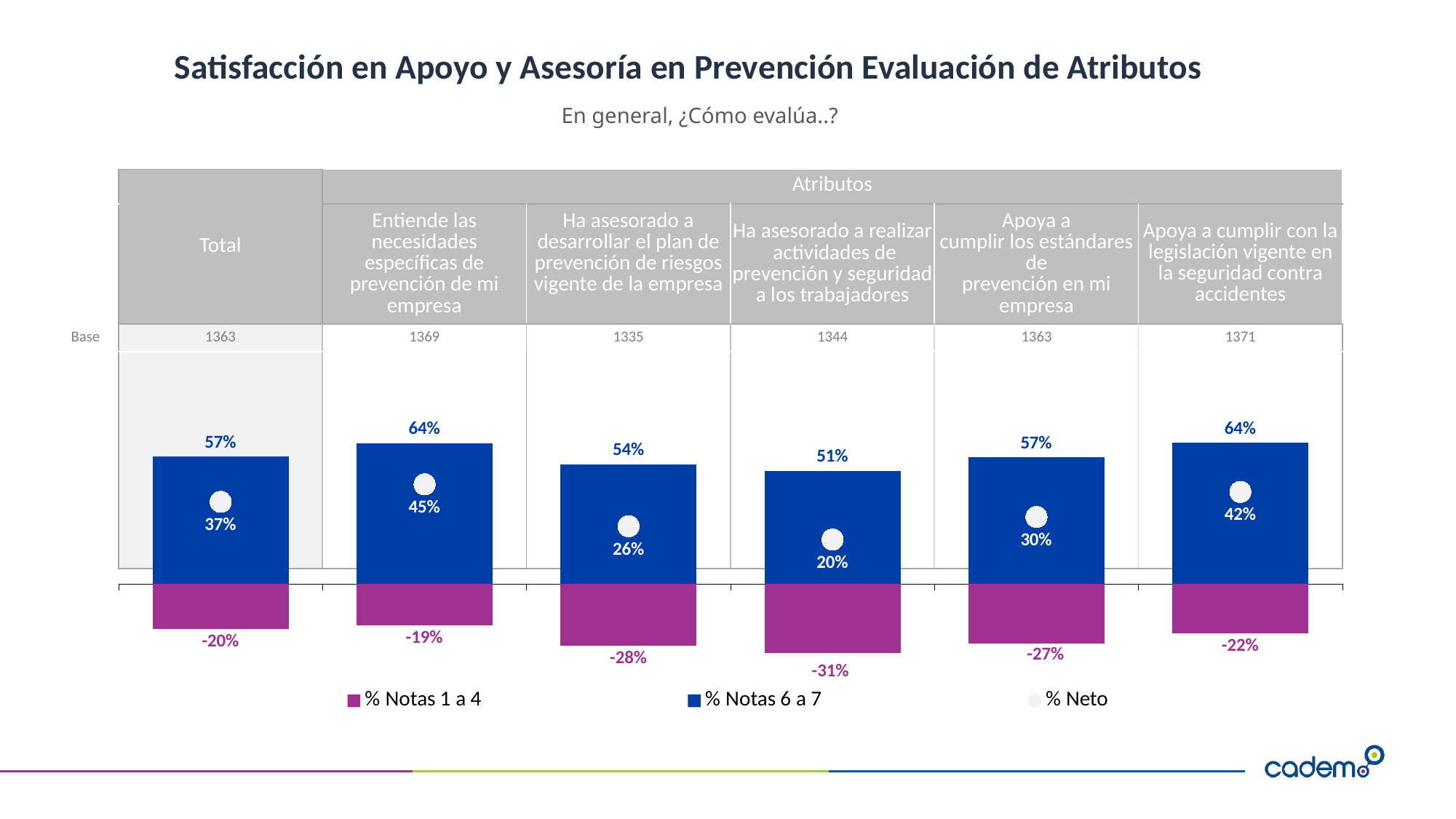
Which has a larger % Neto value: 'Ha asesorado a desarrollar el plan de prevención de riesgos vigente de la empresa' or 'Apoya a cumplir los estándares de prevención en mi empresa'? Apoya a cumplir los estándares de prevención en mi empresa What is the % Notas 6 a 7 value for Total? 57% Which category has the lowest % Notas 6 a 7 value? Ha asesorado a realizar actividades de prevención y seguridad a los trabajadores What is the % Neto value for 'Ha asesorado a realizar actividades de prevención y seguridad a los trabajadores'? 20% What is the difference in % Notas 6 a 7 between 'Apoya a cumplir con la legislación vigente en la seguridad contra accidentes' and 'Ha asesorado a realizar actividades de prevención y seguridad a los trabajadores'? 13 percentage points How many series does the legend list? 3 What is the Base value for 'Ha asesorado a desarrollar el plan de prevención de riesgos vigente de la empresa'? 1335 Which series is shown in purple in the legend? % Notas 1 a 4 Which attribute has the highest % Neto value? Entiende las necesidades específicas de prevención de mi empresa What is the % Notas 1 a 4 value for 'Apoya a cumplir los estándares de prevención en mi empresa'? -27% How many categories are shown in the chart? 6 What kind of chart is shown on the slide? Bar chart